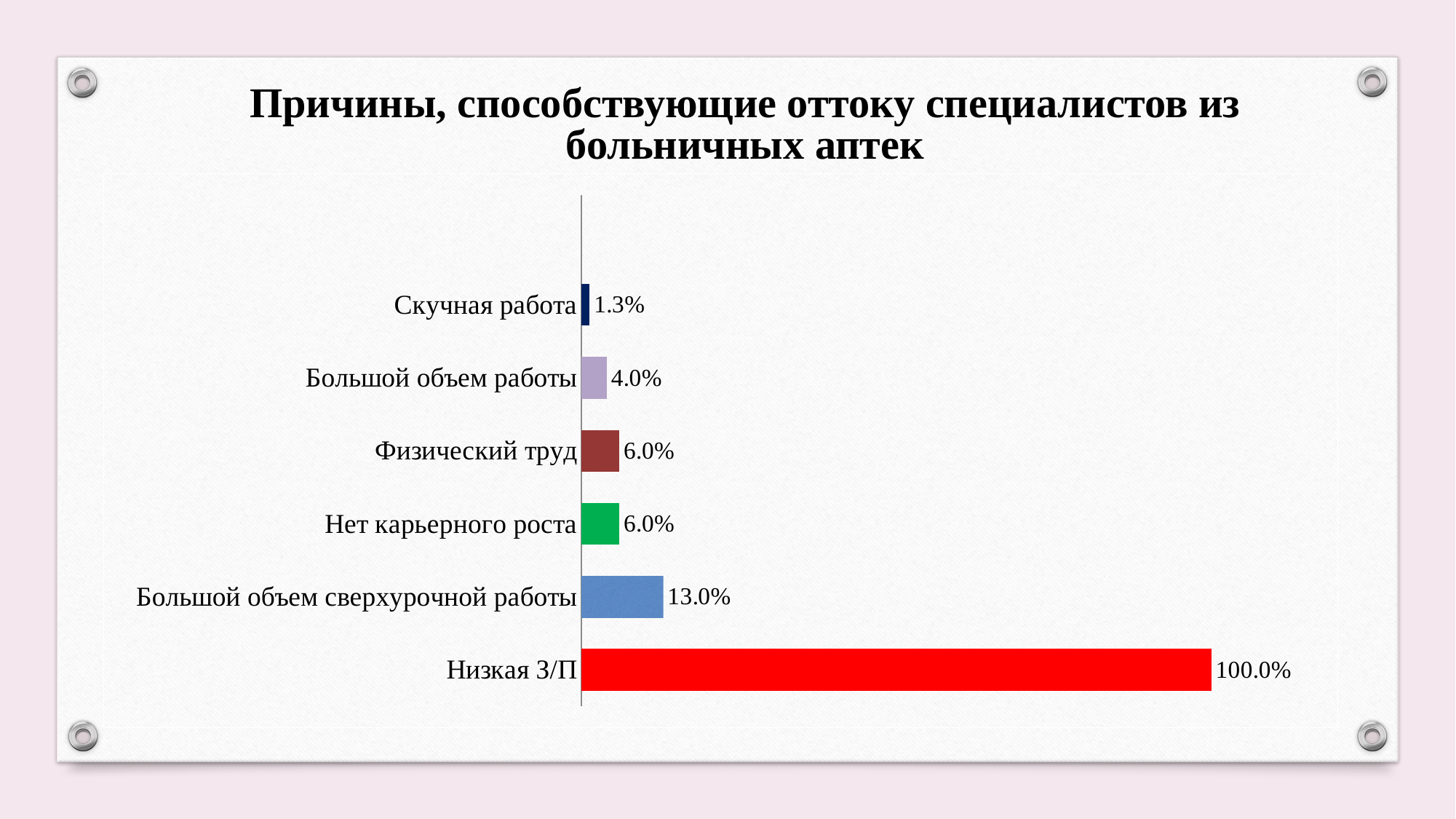
What kind of chart is shown on the slide? Bar chart What is the difference between the values for Физический труд and Большой объем работы? 2.0% Which is larger, the value for Большой объем сверхурочной работы or the value for Нет карьерного роста? Большой объем сверхурочной работы What is the value for Большой объем работы? 4.0% What is the value for Скучная работа? 1.3% Which category has the lowest value? Скучная работа What is the difference between the values for Низкая З/П and Большой объем сверхурочной работы? 87.0% What is the value for Большой объем сверхурочной работы? 13.0% Which category has the highest value? Низкая З/П What is the value for Низкая З/П? 100.0% What is the title of the chart? Причины, способствующие оттоку специалистов из больничных аптек How many categories are shown in the chart? 6